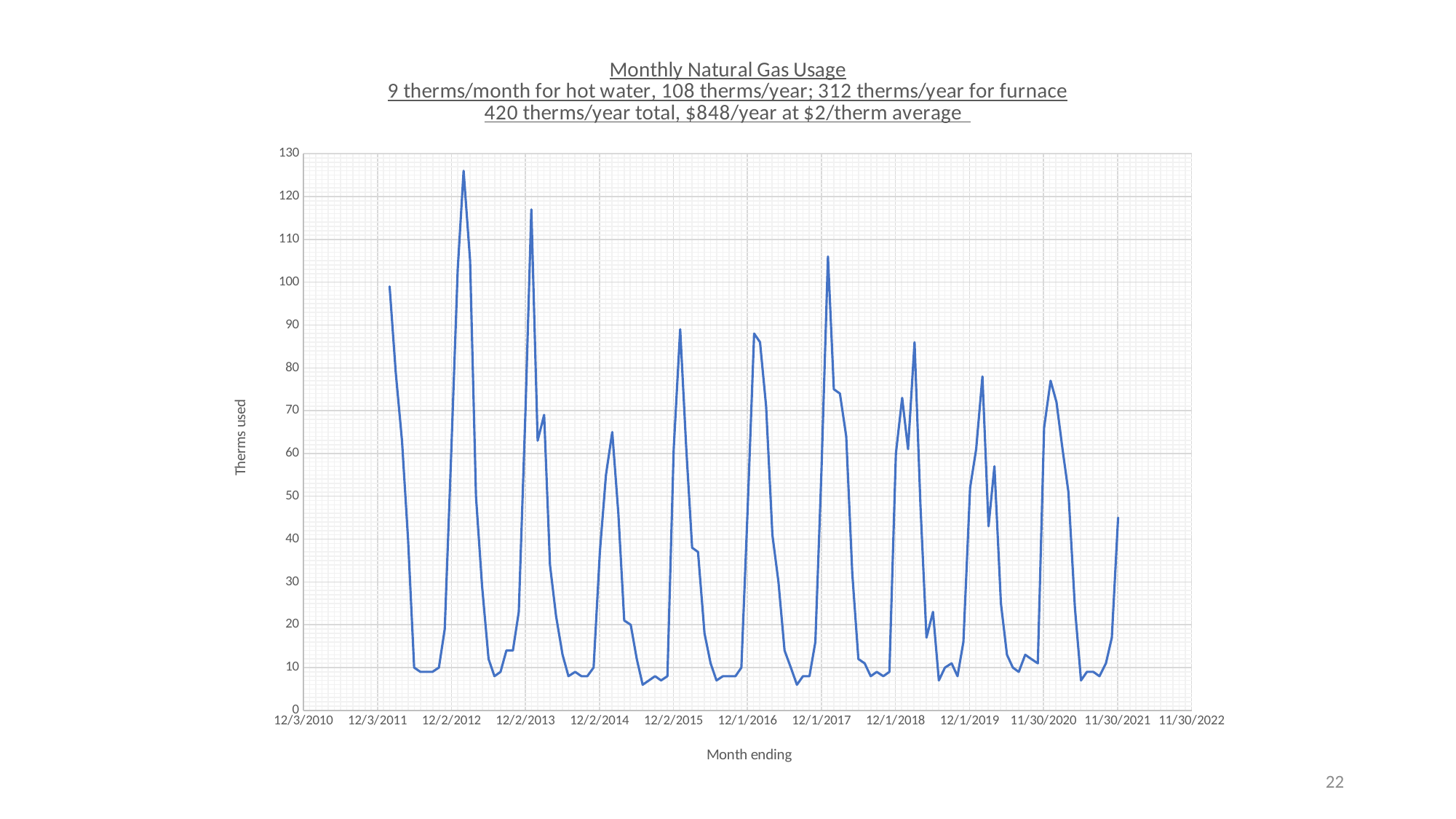
Is the winter peak just after 12/1/2017 greater or less than 100 therms? greater Are the summer low values on the chart greater or less than 10 therms? less Is the highest peak on the chart greater or less than 120 therms? greater Do the winter peaks generally rise or fall from left to right across the chart? fall Near which x-axis date does the line reach its highest value? 12/2/2012 What is the label on the vertical axis of the chart? Therms used What is the first line of the chart's title? Monthly Natural Gas Usage Which winter peak is higher: the one just after 12/2/2012 or the one just after 12/1/2018? the one just after 12/2/2012 What kind of chart is shown on the slide? line chart